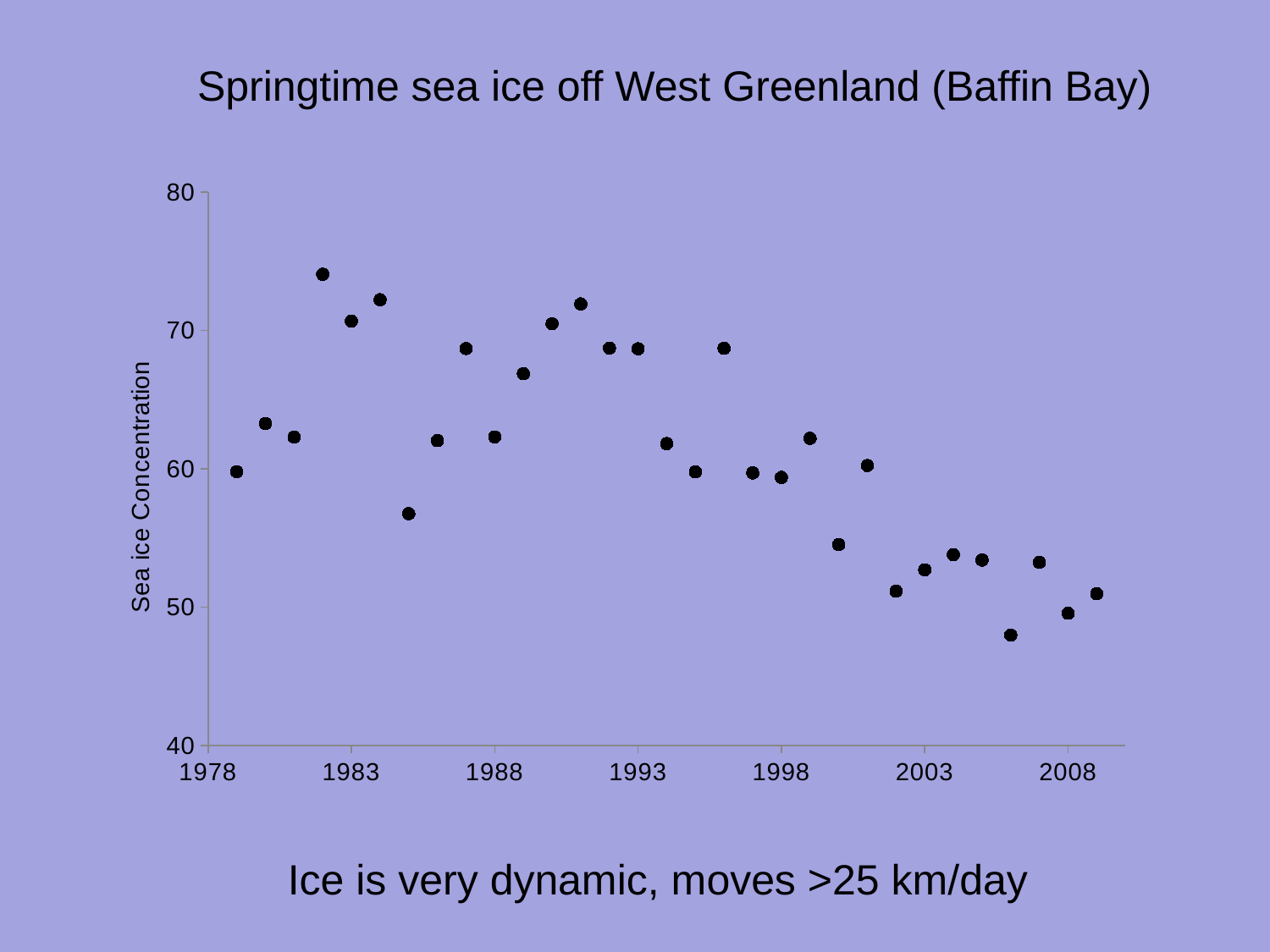
What is the label on the vertical axis of the chart? Sea ice Concentration What is the title of the chart? Springtime sea ice off West Greenland (Baffin Bay) Is the sea ice concentration for 1985 greater or less than 60? less Is the sea ice concentration for 2006 greater or less than 50? less Which year has the larger sea ice concentration, 1991 or 2004? 1991 Is the sea ice concentration for 2000 greater or less than 60? less Overall, do the sea ice concentration values rise or fall from 1978 to 2008 along the x axis? Fall What kind of chart is shown on the slide? Scatter plot In which year is the sea ice concentration highest? 1982 In which year is the sea ice concentration lowest? 2006 How many data points are plotted on the chart? 31